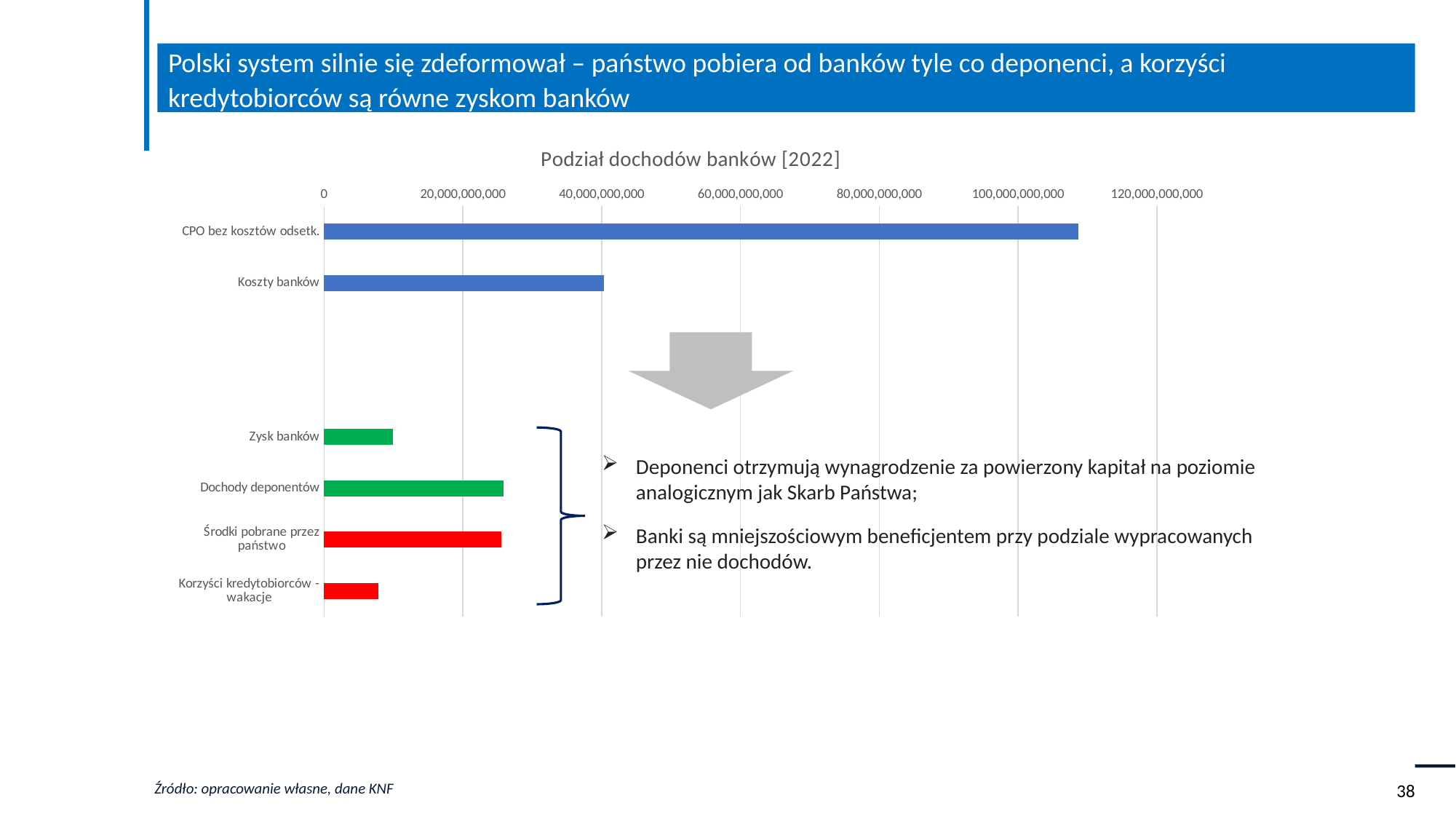
What colour is the bar for Środki pobrane przez państwo? red Is the value for CPO bez kosztów odsetk. greater or less than 100,000,000,000? greater Is the value for Koszty banków greater or less than 20,000,000,000? greater Which category has the lowest value in the chart? Korzyści kredytobiorców - wakacje Which category has the highest value in the chart? CPO bez kosztów odsetk. Is the value for Dochody deponentów greater or less than 20,000,000,000? greater What is the title of the chart? Podział dochodów banków [2022] What kind of chart is shown on the slide? bar chart Which is larger, the value for Koszty banków or the value for Dochody deponentów? Koszty banków How many categories are plotted in the chart? 6